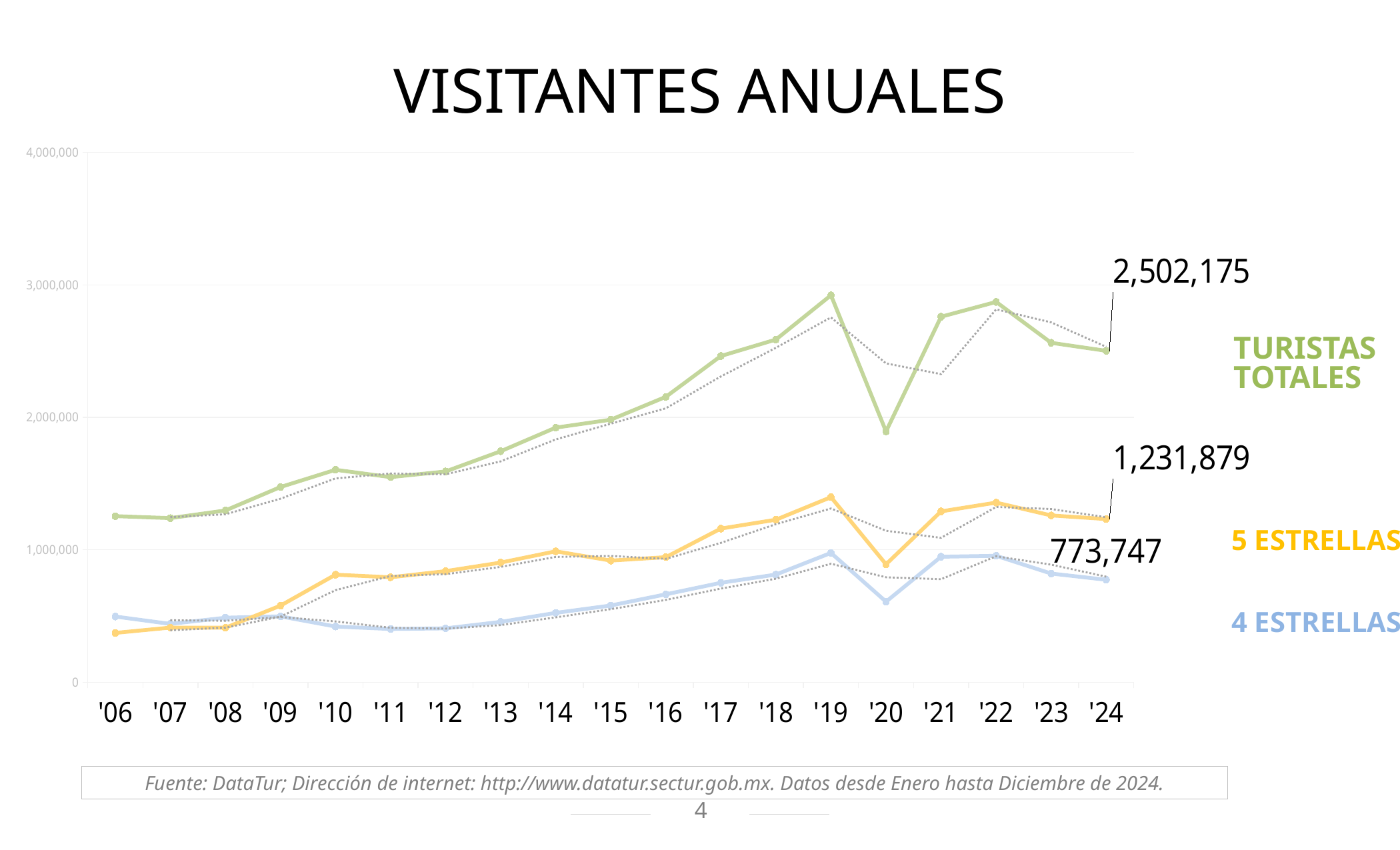
How many years are shown on the x axis? 19 Does the TURISTAS TOTALES line rise or fall from '06 to '19? rise What is the value for 5 ESTRELLAS in '24? 1,231,879 Is the value for TURISTAS TOTALES in '20 greater or less than 2,000,000? less What is the value for 4 ESTRELLAS in '24? 773,747 What is the difference between 5 ESTRELLAS and 4 ESTRELLAS in '24? 458,132 Which is larger for TURISTAS TOTALES: the value in '19 or the value in '20? '19 How many series are labelled on the chart? 3 What is the value for TURISTAS TOTALES in '24? 2,502,175 What kind of chart is shown on the slide? line chart Is the value for 5 ESTRELLAS in '19 greater or less than 1,000,000? greater What is the difference between TURISTAS TOTALES and 5 ESTRELLAS in '24? 1,270,296